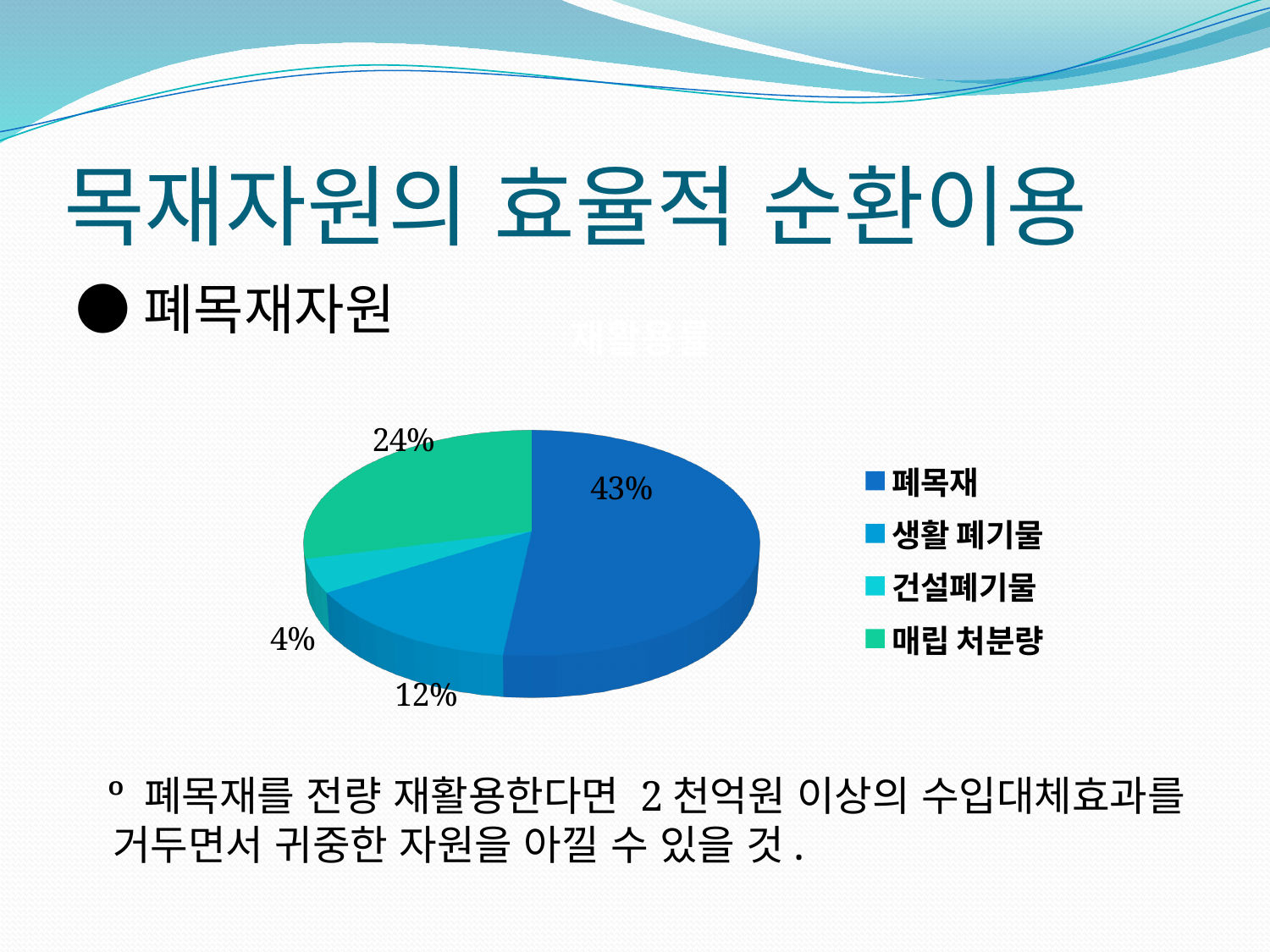
Which category has the smallest slice in the pie chart? 건설폐기물 What colour is the slice for 매립 처분량 in the pie chart? Green What type of chart is shown on the slide? Pie chart What percentage is shown for 건설폐기물 in the pie chart? 4% What percentage is shown for 폐목재 in the pie chart? 43% Which is larger, the slice for 생활 폐기물 or the slice for 매립 처분량? 매립 처분량 Which category has the largest slice in the pie chart? 폐목재 How many entries does the legend list? 4 What is the difference in percentage points between 폐목재 and 매립 처분량? 19 What percentage is shown for 생활 폐기물 in the pie chart? 12% How many slices does the pie chart have? 4 What percentage is shown for 매립 처분량 in the pie chart? 24%